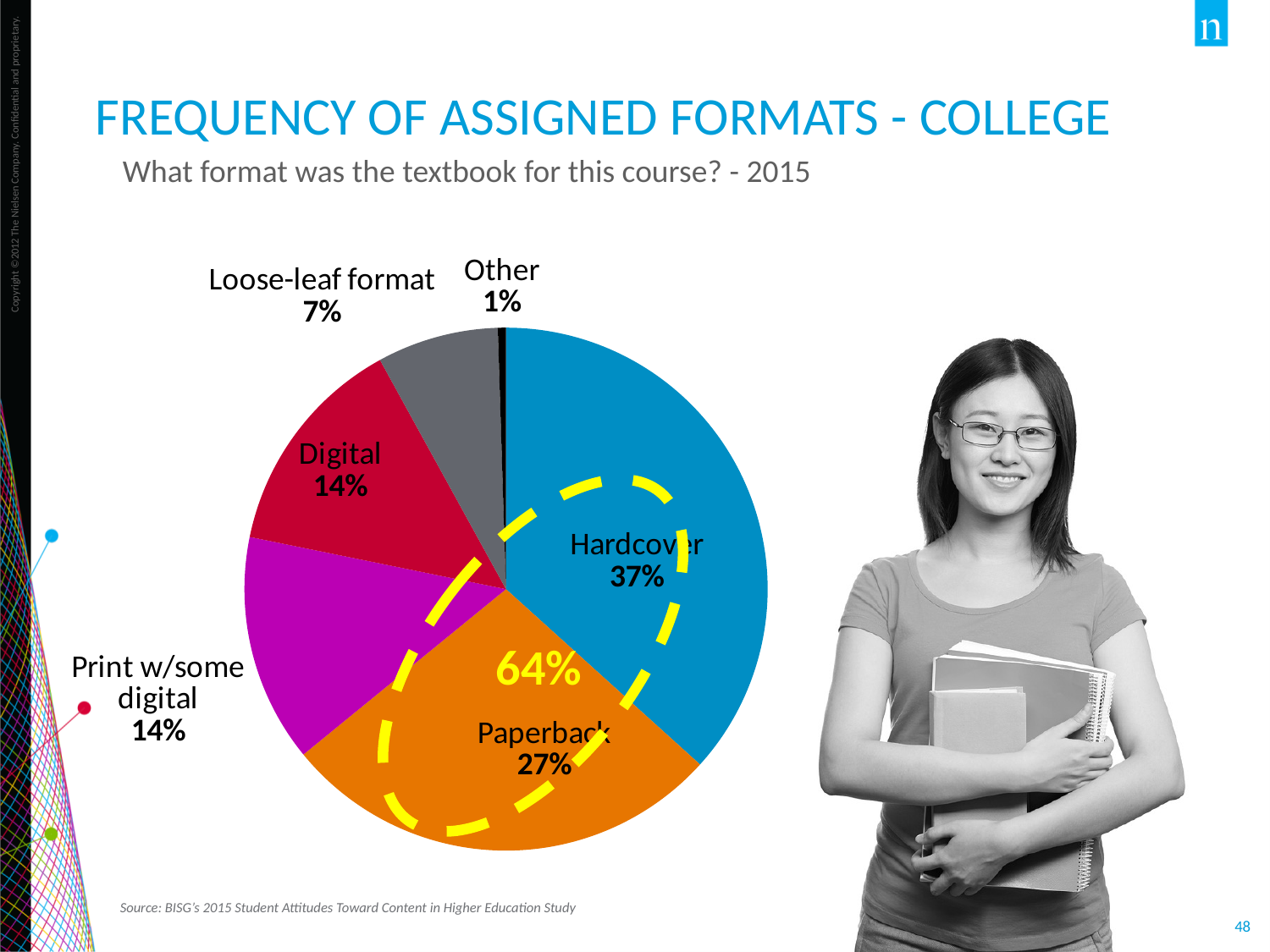
What share of the pie does Other represent? 1% How many slices does the pie chart have? 6 Which format has the largest share of the pie? Hardcover What kind of chart is shown on the slide? Pie chart What combined percentage is highlighted by the dashed yellow outline covering Hardcover and Paperback? 64% What share of the pie does Hardcover represent? 37% What is the difference between the Hardcover and Paperback shares? 10% What share of the pie does Paperback represent? 27% Which is larger, the share for Digital or the share for Loose-leaf format? Digital What is the title of the chart on the slide? Frequency of Assigned Formats - College Which format has the smallest share of the pie? Other What share of the pie does Loose-leaf format represent? 7%